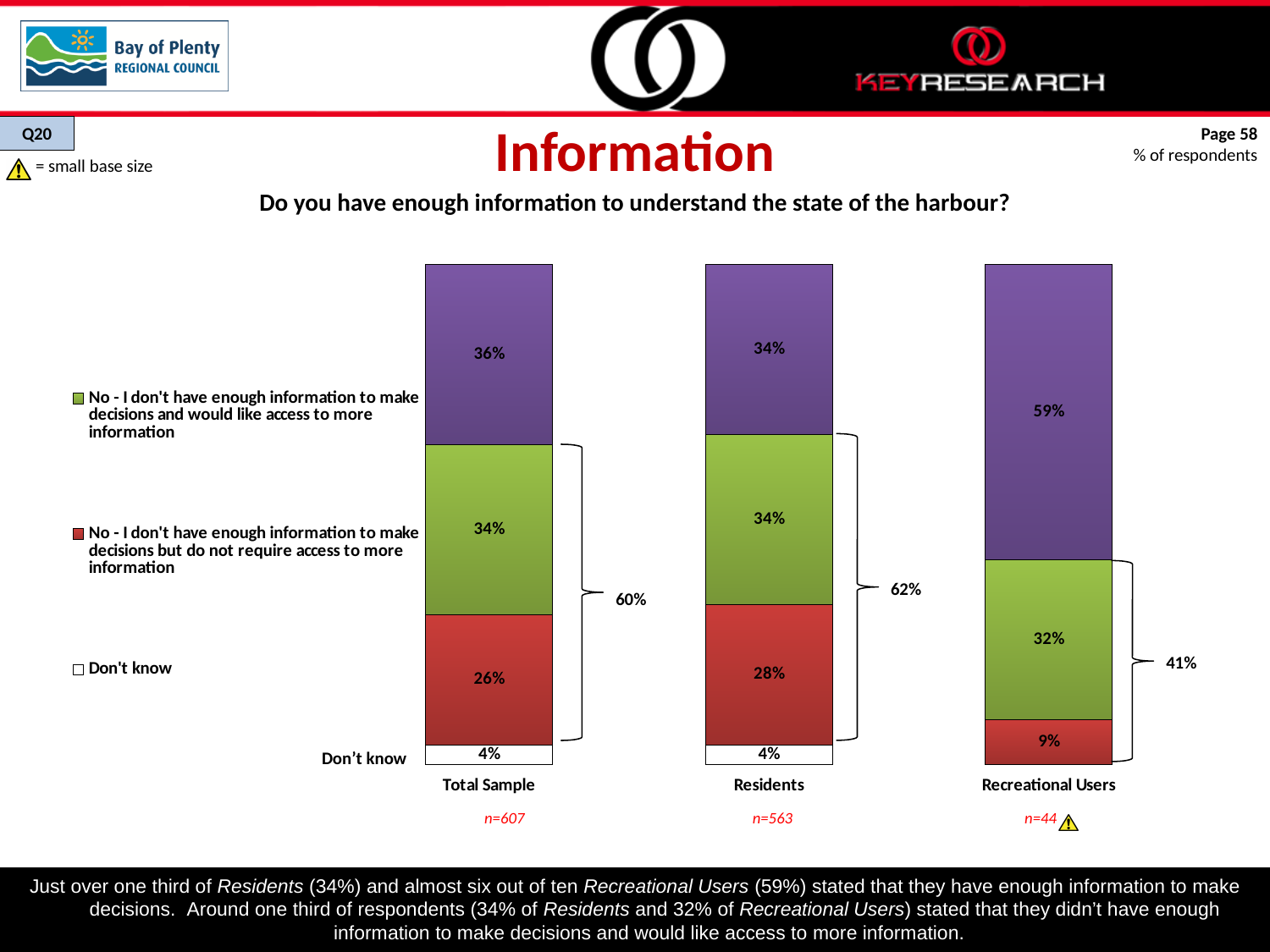
Which group has the largest purple (top) segment? Recreational Users What combined percentage is shown by the bracket for the Recreational Users bar? 41% What type of chart is used on this slide? Stacked bar chart Which is larger: the red segment for the Total Sample or the red segment for Residents? Residents What is the difference in percentage points between the green segment for Residents and the green segment for Recreational Users? 2 percentage points What percentage of Recreational Users said they don't have enough information to make decisions and would like access to more information (green segment)? 32% How many respondent groups (bars) are shown in the chart? 3 What percentage of Residents said they don't have enough information to make decisions but do not require access to more information (red segment)? 28% Which group has the smallest red segment? Recreational Users What combined percentage is shown by the bracket for the Residents bar? 62% What percentage of the Total Sample answered "Don't know"? 4% What is the sample size (n) shown for Residents? n=563